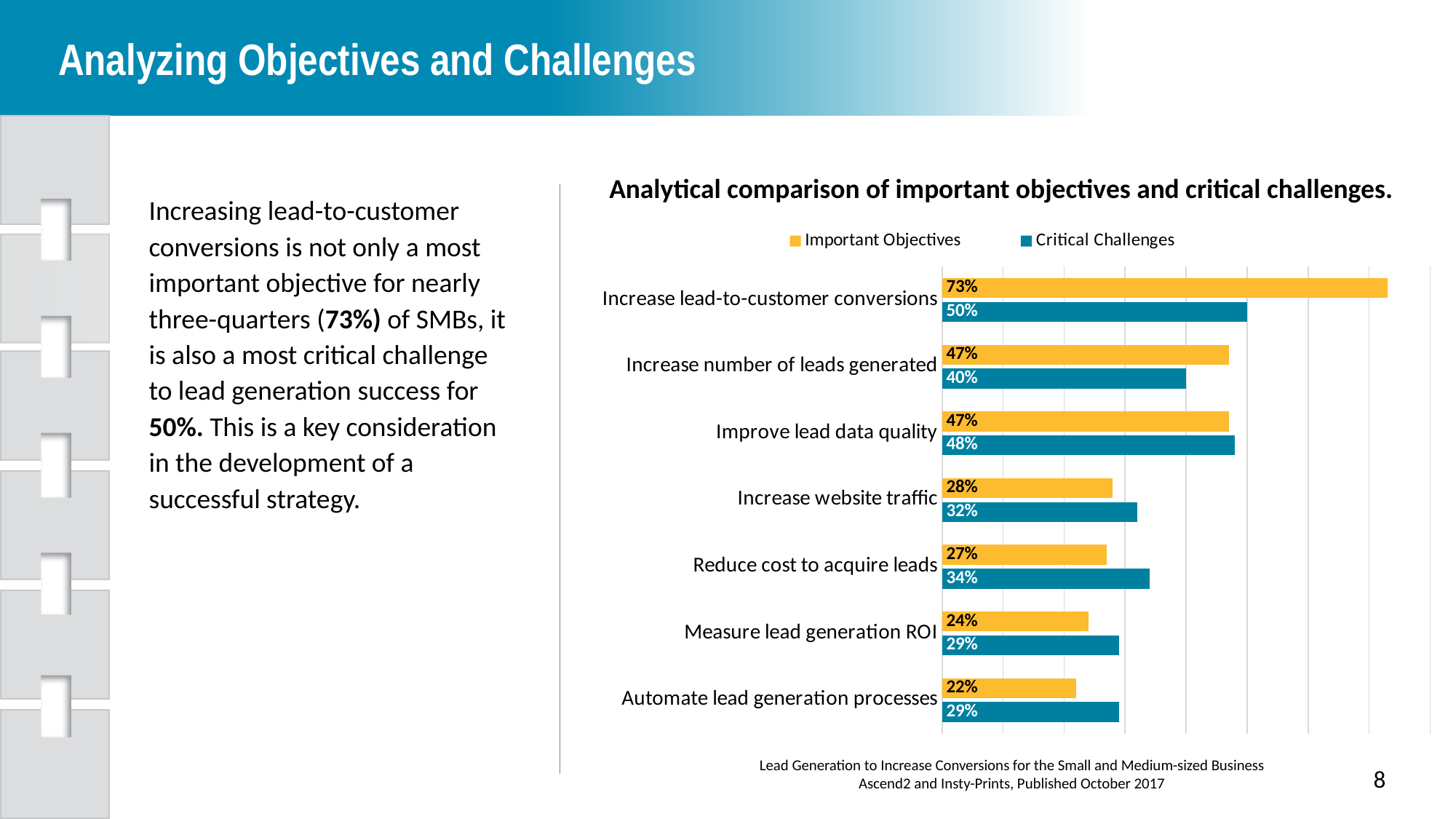
What is the difference between the Important Objectives and Critical Challenges values for Increase lead-to-customer conversions? 23% What is the title of the chart? Analytical comparison of important objectives and critical challenges. What kind of chart is shown on the slide? Bar chart How many categories are shown in the chart? 7 What is the Critical Challenges value for Reduce cost to acquire leads? 34% How many series does the legend list? 2 Which category has the lowest Important Objectives value? Automate lead generation processes What is the Important Objectives value for Increase lead-to-customer conversions? 73% Which colour represents the Critical Challenges series? Blue For Improve lead data quality, which is larger: Important Objectives or Critical Challenges? Critical Challenges What is the Important Objectives value for Automate lead generation processes? 22% Which category has the highest Critical Challenges value? Increase lead-to-customer conversions